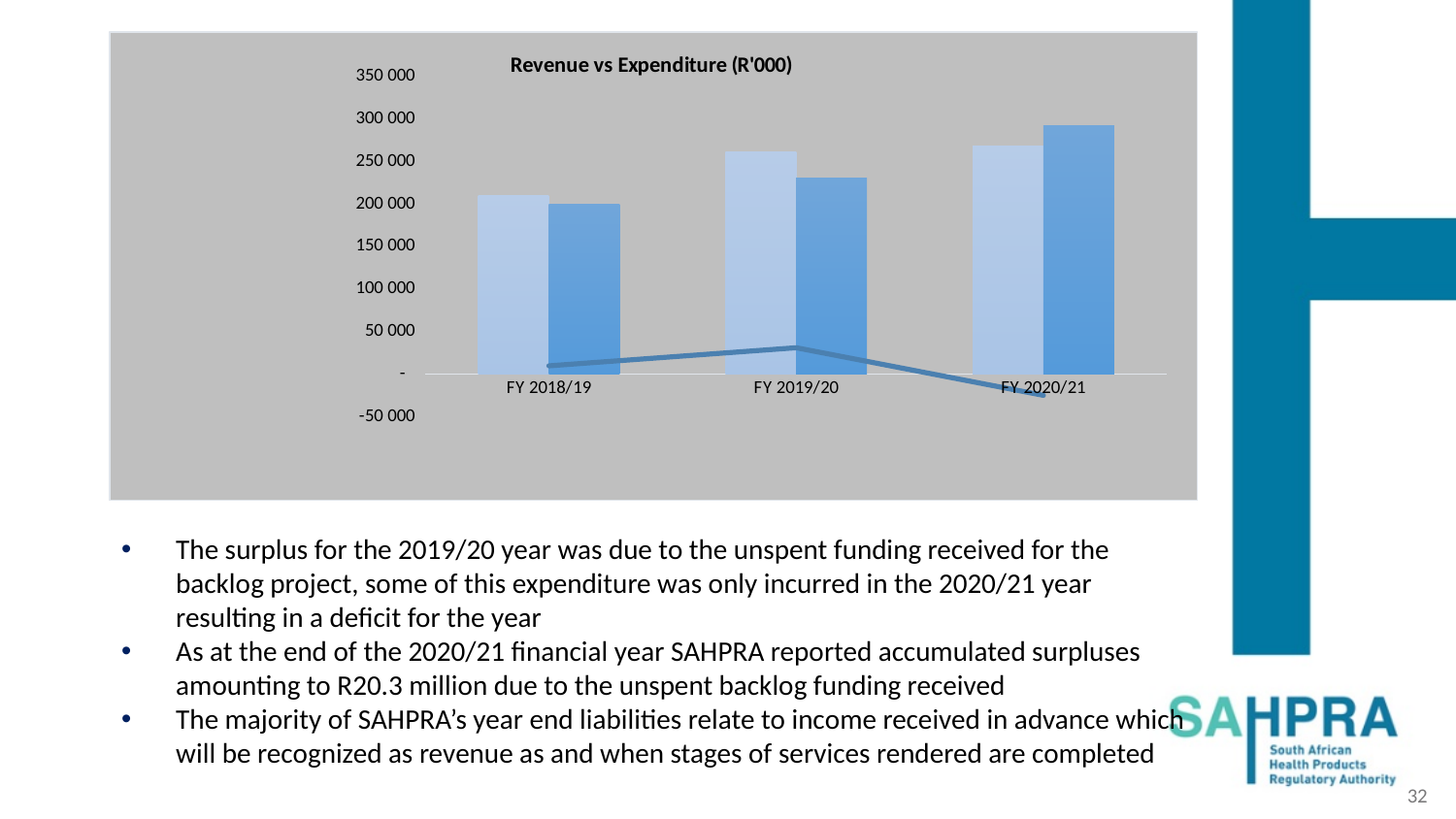
In FY 2020/21, which bar is taller, the lighter blue bar or the darker blue bar? the darker blue bar Do the darker blue bars rise or fall from FY 2018/19 to FY 2020/21? rise How many financial years are shown on the x axis of the chart? 3 What is the title of the chart? Revenue vs Expenditure (R'000) What kind of chart is shown on the slide? combination bar and line chart Is the darker blue bar for FY 2020/21 greater or less than 250 000? greater Is the darker blue bar for FY 2019/20 greater or less than 200 000? greater Which financial year has the shortest lighter blue bar? FY 2018/19 Which financial year has the tallest darker blue bar? FY 2020/21 Which financial year has the shortest darker blue bar? FY 2018/19 Is the lighter blue bar for FY 2018/19 greater or less than 250 000? less In FY 2019/20, which bar is taller, the lighter blue bar or the darker blue bar? the lighter blue bar